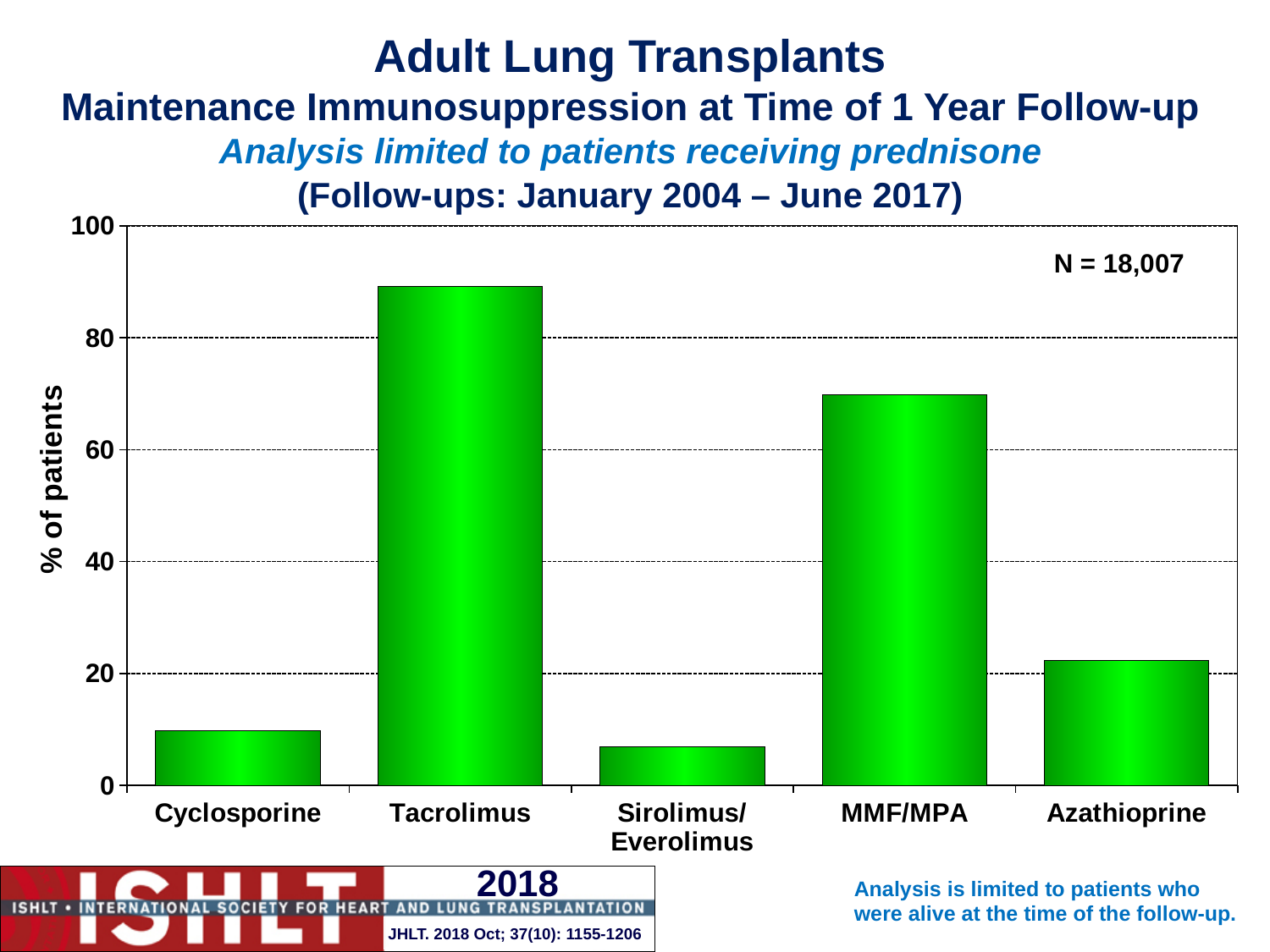
Which category has the highest percentage of patients? Tacrolimus Which is larger, the value for Tacrolimus or the value for MMF/MPA? Tacrolimus What kind of chart is shown on the slide? bar chart How many immunosuppression categories are shown on the x axis? 5 Which category has the lowest percentage of patients? Sirolimus/Everolimus Which is larger, the value for Azathioprine or the value for Cyclosporine? Azathioprine Is the value for Azathioprine greater or less than 40? less What is the label on the y axis of the chart? % of patients Is the value for MMF/MPA greater or less than 60? greater Is the value for MMF/MPA greater or less than 80? less